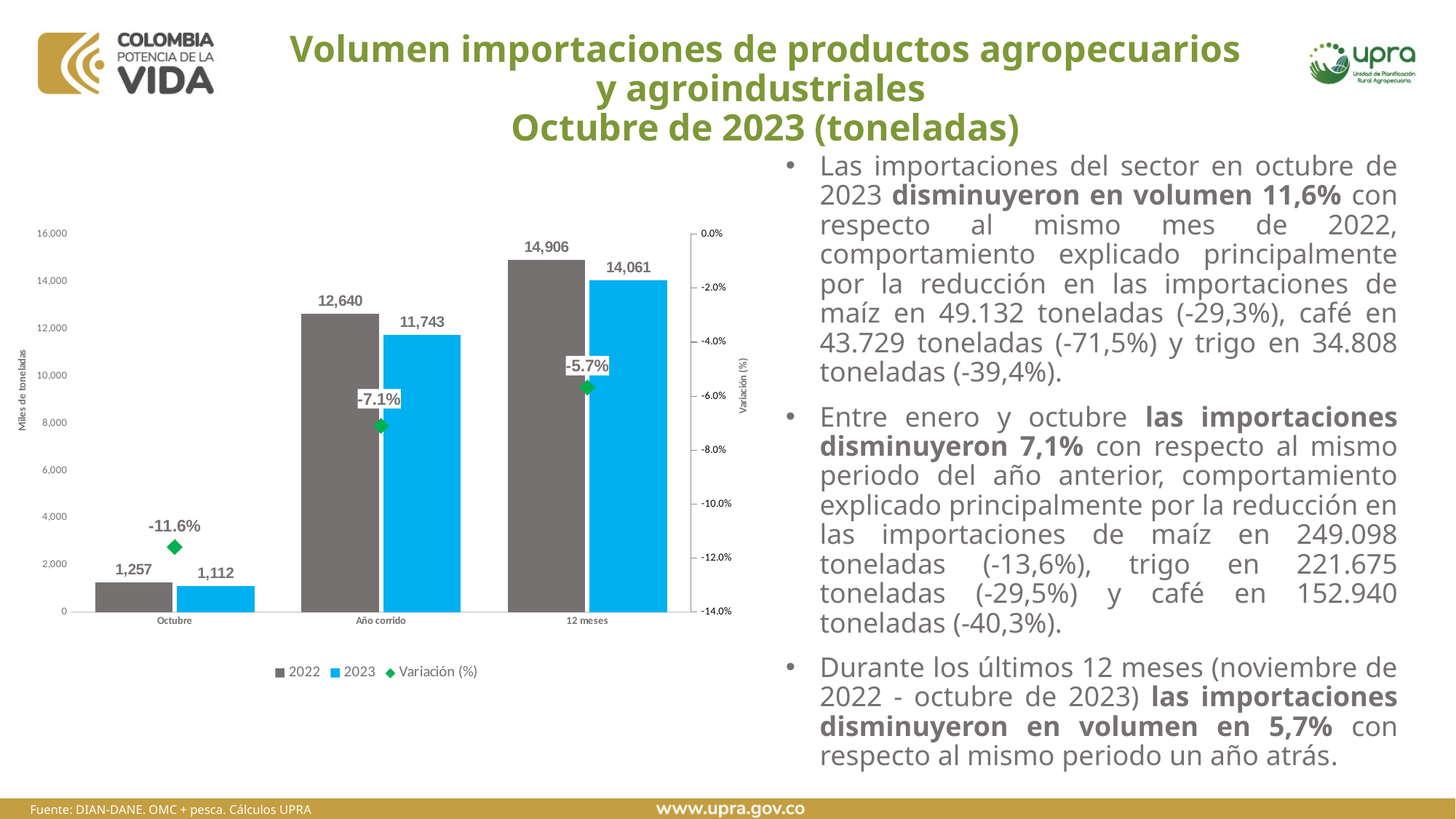
How many series does the legend list? 3 What is the label of the left vertical axis? Miles de toneladas What is the value for 2023 in the Año corrido category? 11,743 What is the difference between the 2022 and 2023 values in the 12 meses category? 845 What is the Variación (%) value for the 12 meses category? -5.7% Which category has the lowest value for the 2023 series? Octubre What kind of chart is shown on the slide? Bar chart with a marker series How many categories are shown on the x axis? 3 What is the Variación (%) value for the Octubre category? -11.6% What is the value for 2022 in the Octubre category? 1,257 In the Año corrido category, which is larger, the 2022 value or the 2023 value? 2022 Which category has the highest value for the 2022 series? 12 meses